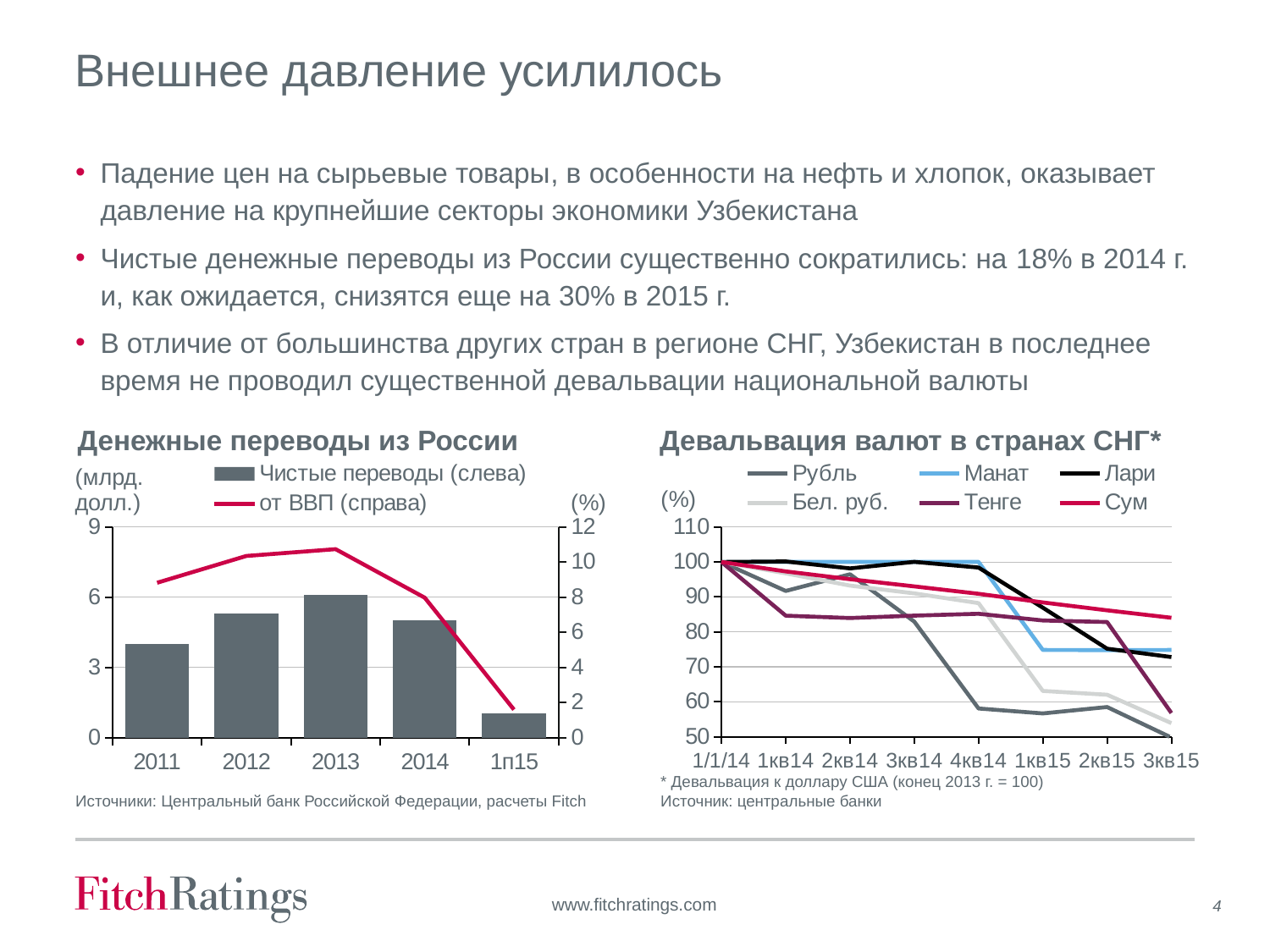
On the chart titled 'Денежные переводы из России', does the 'от ВВП' line rise or fall from 2013 to 1п15? fall On the chart titled 'Денежные переводы из России', which period has the lowest bar for 'Чистые переводы'? 1п15 On the chart titled 'Денежные переводы из России', what kind of chart is used for the 'Чистые переводы' series? bar chart On the chart titled 'Девальвация валют в странах СНГ*', is the value for 'Рубль' at 4кв14 greater or less than 70? less On the chart titled 'Денежные переводы из России', how many series does the legend list? 2 On the chart titled 'Денежные переводы из России', is the 'Чистые переводы' bar for 2011 greater or less than 6? less On the chart titled 'Девальвация валют в странах СНГ*', how many series does the legend list? 6 On the chart titled 'Денежные переводы из России', which period has the highest bar for 'Чистые переводы'? 2013 On the chart titled 'Девальвация валют в странах СНГ*', which currency has the highest value at 3кв15? Сум On the chart titled 'Девальвация валют в странах СНГ*', which currency has the lowest value at 3кв15? Рубль On the chart titled 'Девальвация валют в странах СНГ*', how many points are shown on the x axis? 8 On the chart titled 'Денежные переводы из России', how many periods are shown on the x axis? 5